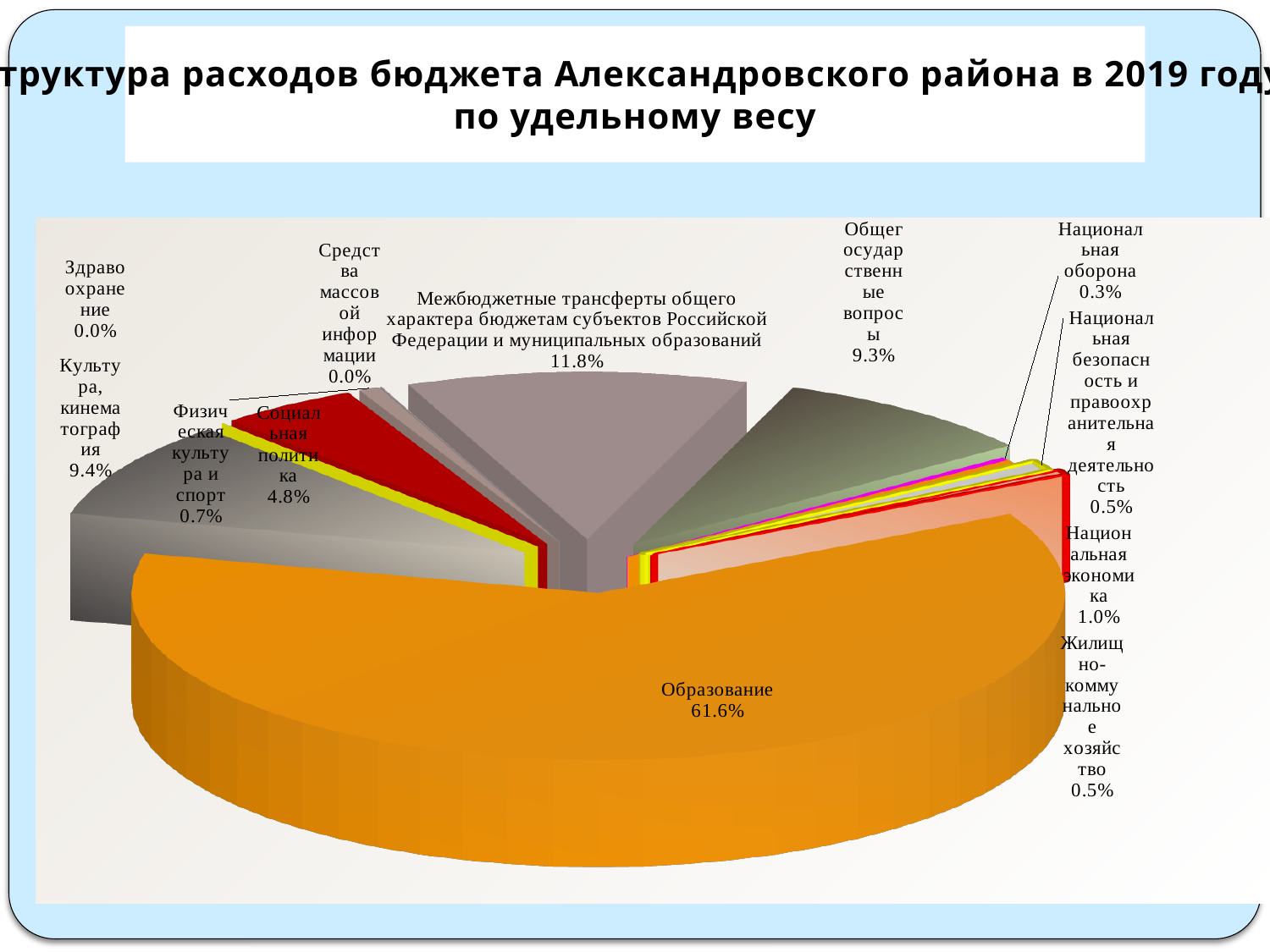
What is the difference in share between Образование and Межбюджетные трансферты общего характера? 49.8% What is the share for Общегосударственные вопросы? 9.3% What is the share for Культура, кинематография? 9.4% What is the share for Национальная оборона? 0.3% Which category has the largest share of the pie? Образование Which year does the chart title say the budget expenditure structure refers to? 2019 What is the share for Межбюджетные трансферты общего характера бюджетам субъектов Российской Федерации и муниципальных образований? 11.8% What is the share for Социальная политика? 4.8% What kind of chart is shown on the slide? Pie chart What share of the budget expenditure goes to Образование? 61.6% Which has the larger share: Социальная политика or Национальная экономика? Социальная политика How many categories are labelled on the pie chart? 12